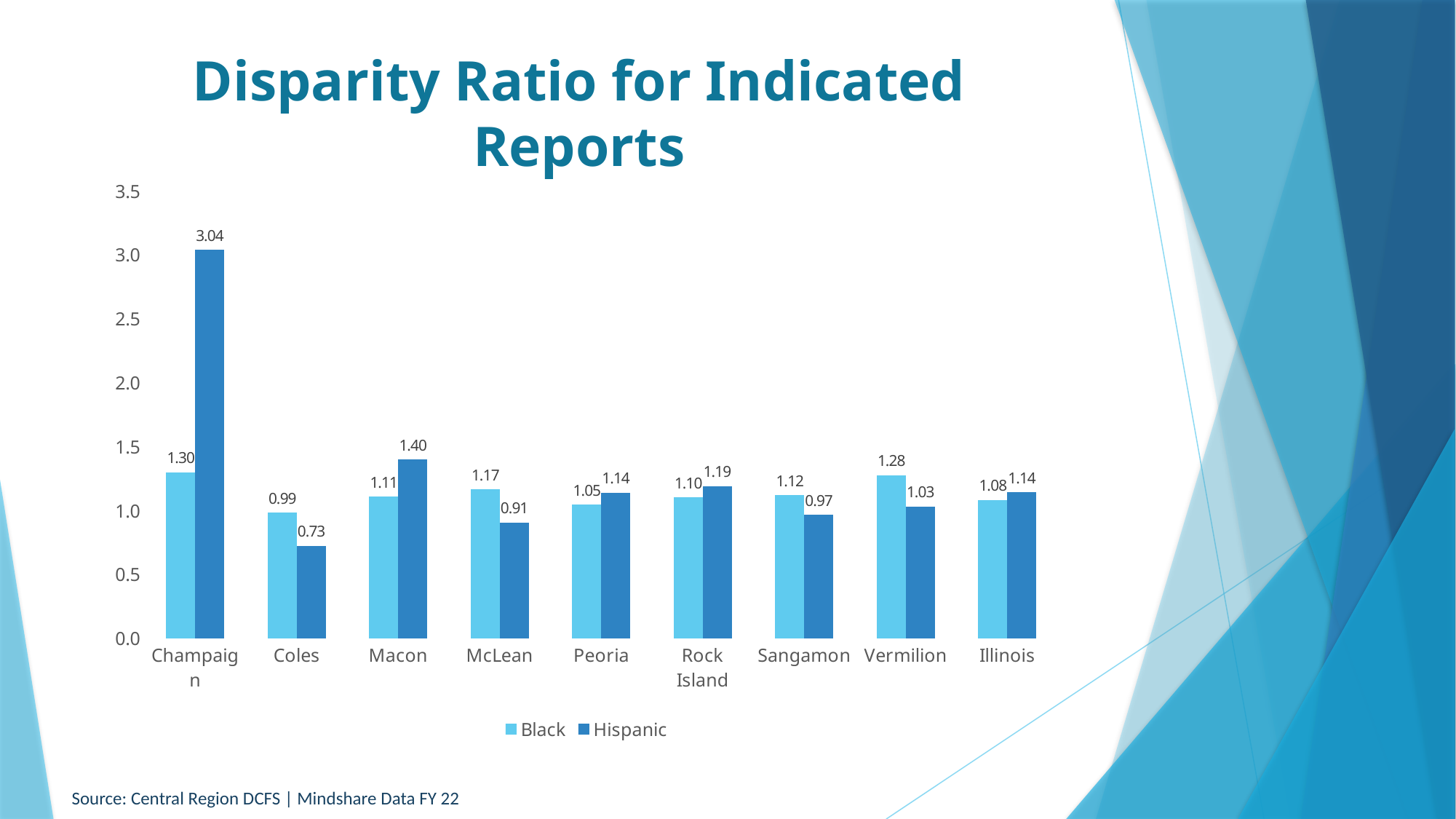
What is the title of the chart? Disparity Ratio for Indicated Reports Which is larger for McLean, the Black or the Hispanic disparity ratio? Black What is the Black disparity ratio for Vermilion? 1.28 What is the Hispanic disparity ratio for Coles? 0.73 How many categories are shown on the x axis? 9 What kind of chart is shown on the slide? Bar chart Is the Hispanic value for Champaign greater or less than 3.0? greater What is the Hispanic disparity ratio for Champaign? 3.04 Which category has the lowest Black disparity ratio? Coles How many series does the legend list? 2 What is the difference between the Hispanic and Black disparity ratios for Champaign? 1.74 Which category has the highest Hispanic disparity ratio? Champaign